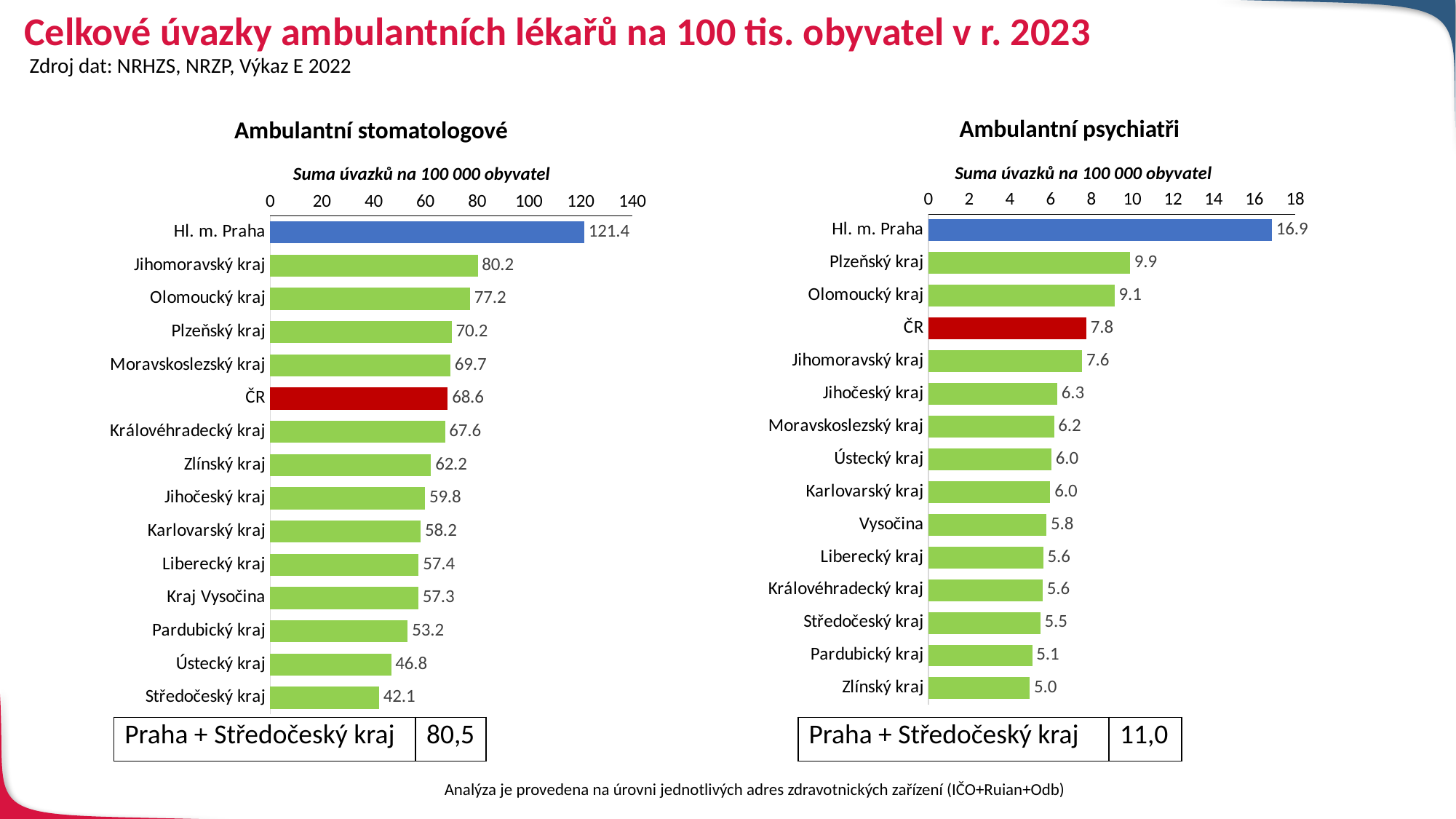
In the 'Ambulantní stomatologové' chart, what is the value for Hl. m. Praha? 121.4 How many bars are plotted in the 'Ambulantní stomatologové' chart? 15 In the 'Ambulantní psychiatři' chart, is the value for Olomoucký kraj greater or less than 8? greater In the 'Ambulantní psychiatři' chart, which category has the highest value? Hl. m. Praha What kind of chart is the 'Ambulantní psychiatři' chart? Bar chart In the 'Ambulantní stomatologové' chart, which is larger, the value for Olomoucký kraj or the value for Plzeňský kraj? Olomoucký kraj In the 'Ambulantní stomatologové' chart, what is the value for ČR? 68.6 In the 'Ambulantní psychiatři' chart, what is the axis title shown above the value axis? Suma úvazků na 100 000 obyvatel In the 'Ambulantní stomatologové' chart, what is the difference between the values for Hl. m. Praha and Středočeský kraj? 79.3 In the 'Ambulantní stomatologové' chart, which category has the lowest value? Středočeský kraj In the 'Ambulantní psychiatři' chart, what is the difference between the values for ČR and Zlínský kraj? 2.8 In the 'Ambulantní psychiatři' chart, what is the value for Plzeňský kraj? 9.9